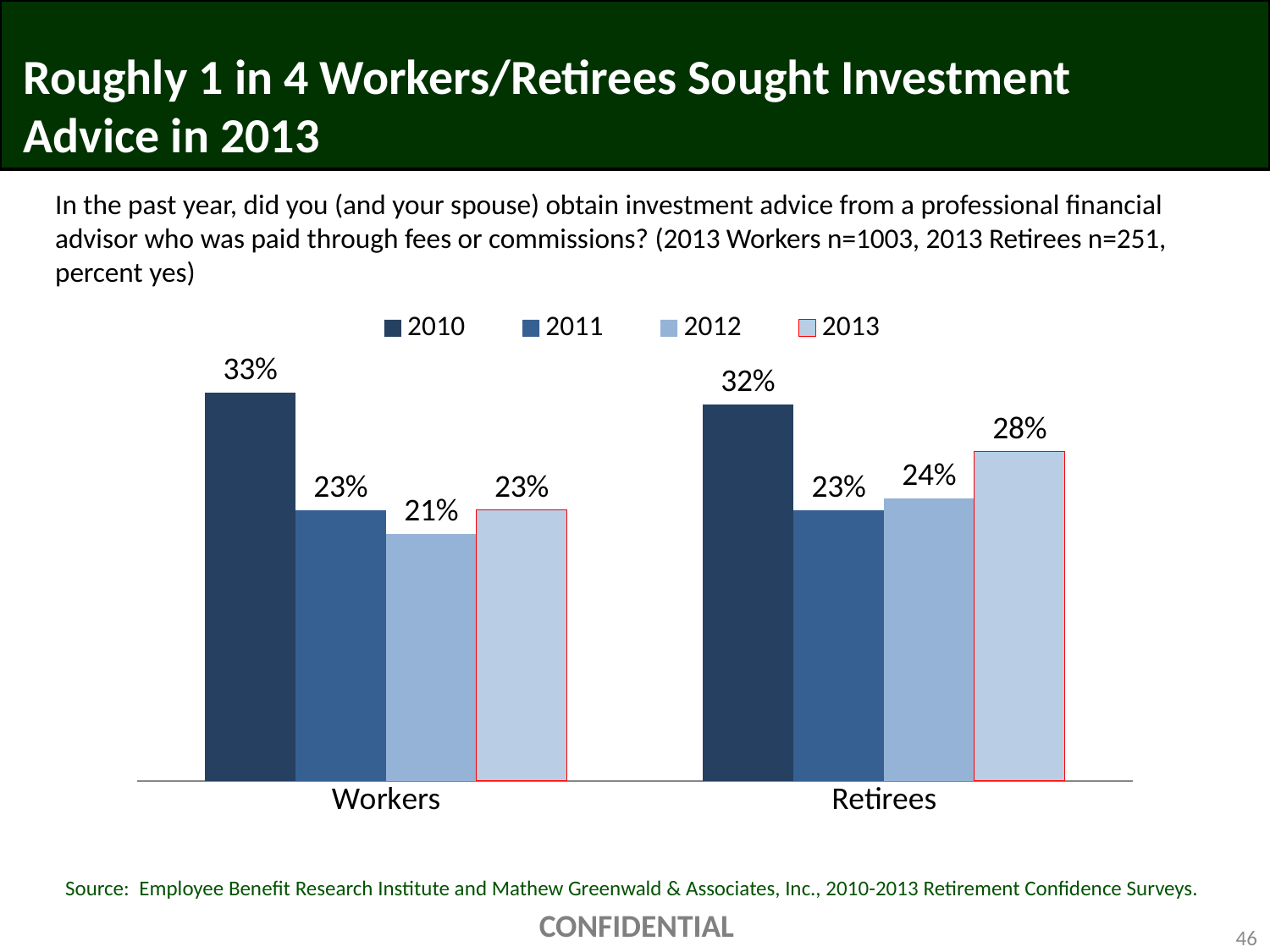
What is the value for Retirees in 2011? 23% How many categories are shown on the x axis? 2 Which year has the highest value for Retirees? 2010 Which year has the lowest value for Workers? 2012 What percentage of Workers obtained investment advice in 2010? 33% What kind of chart is shown on the slide? Bar chart What is the difference between the Workers values for 2010 and 2013? 10 percentage points In 2012, which group has the larger value, Workers or Retirees? Retirees How many series does the legend list? 4 What is the difference between the Retirees and Workers values for 2013? 5 percentage points What percentage of Retirees obtained investment advice in 2013? 28% What is the value for Workers in 2012? 21%